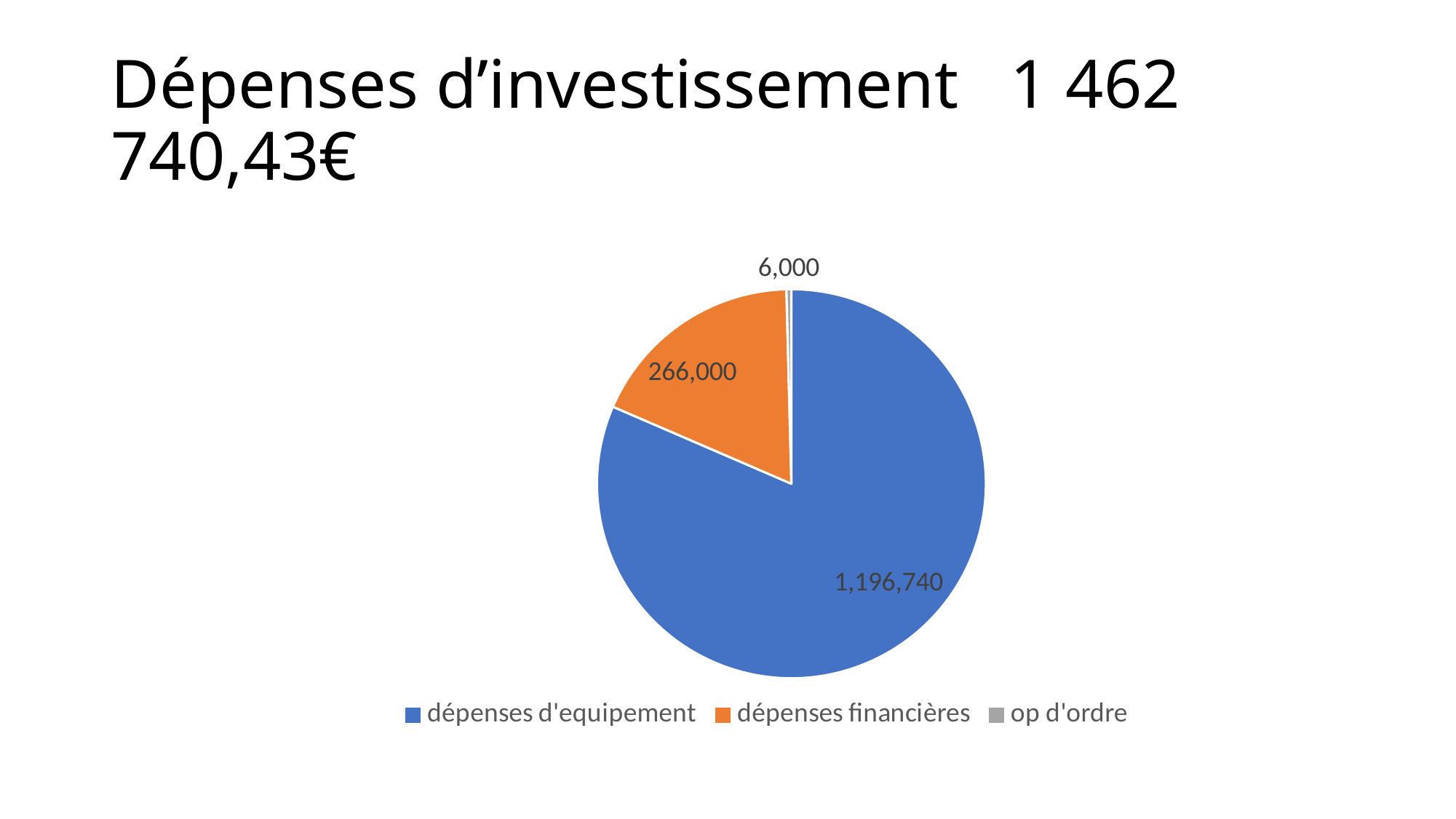
What is the difference between dépenses d'equipement and dépenses financières? 930,740 What kind of chart is shown on the slide? pie chart What share of the pie does dépenses financières represent, to one decimal place? 18.1% How many slices does the pie chart have? 3 What is the difference between dépenses financières and op d'ordre? 260,000 What is the value for dépenses financières? 266,000 Which category has the largest slice of the pie? dépenses d'equipement What is the value for op d'ordre? 6,000 What is the value for dépenses d'equipement? 1,196,740 Which category has the smallest slice of the pie? op d'ordre Which is larger, dépenses financières or op d'ordre? dépenses financières What colour is the slice for dépenses d'equipement? blue